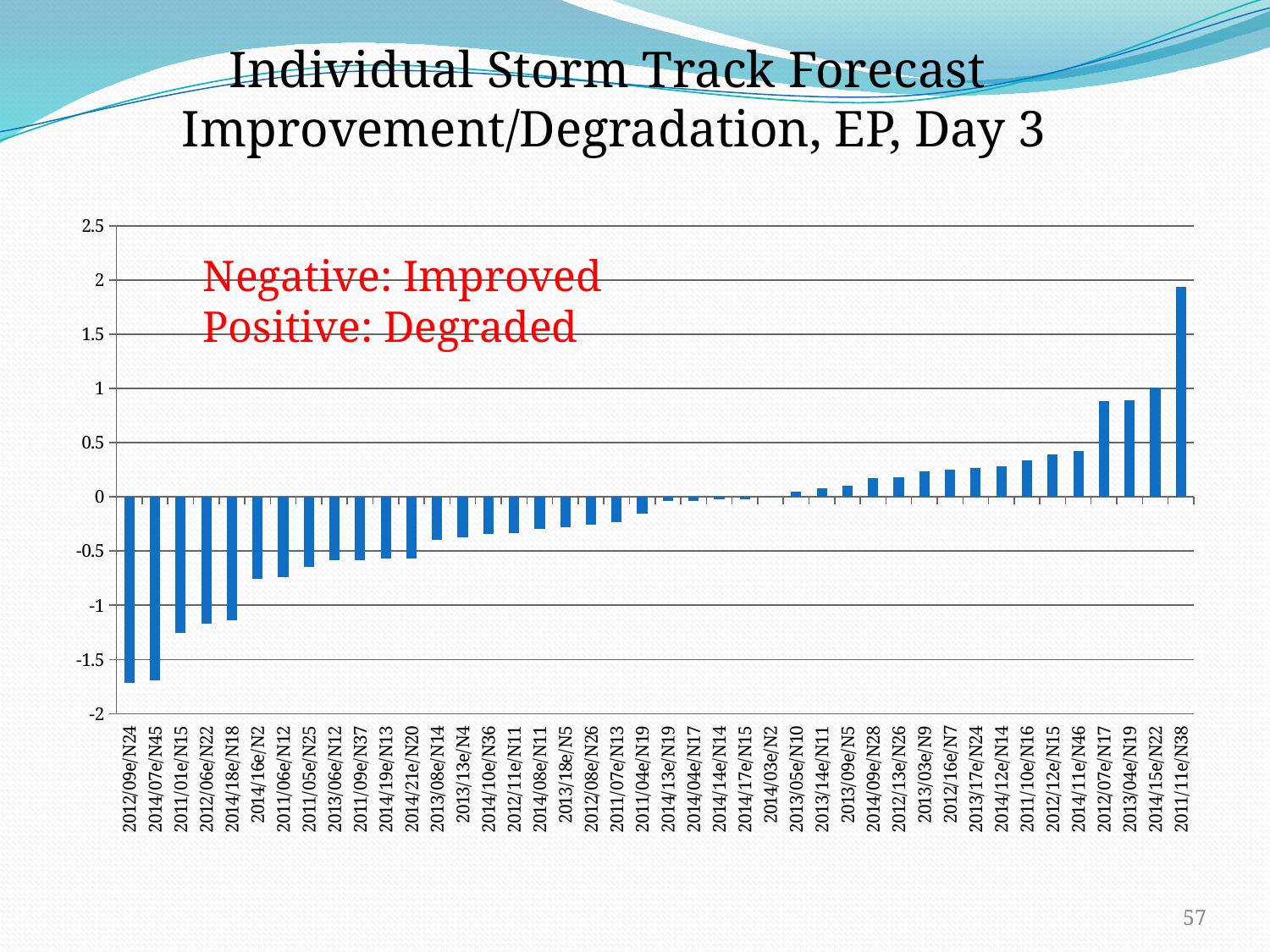
Is the value for 2011/11e/N38 greater or less than 1.5? greater Is the value for 2012/09e/N24 greater or less than -1.5? less How many storm categories are plotted along the x axis? 42 What is the title of the chart? Individual Storm Track Forecast Improvement/Degradation, EP, Day 3 What kind of chart is shown on the slide? bar chart Which has the larger value, 2011/11e/N38 or 2014/15e/N22? 2011/11e/N38 Is the value for 2013/08e/N14 greater or less than -0.5? greater Which storm has the highest value in the chart? 2011/11e/N38 Do the values generally rise or fall moving from left to right along the x axis? rise According to the annotation on the chart, what does a negative value indicate? Improved